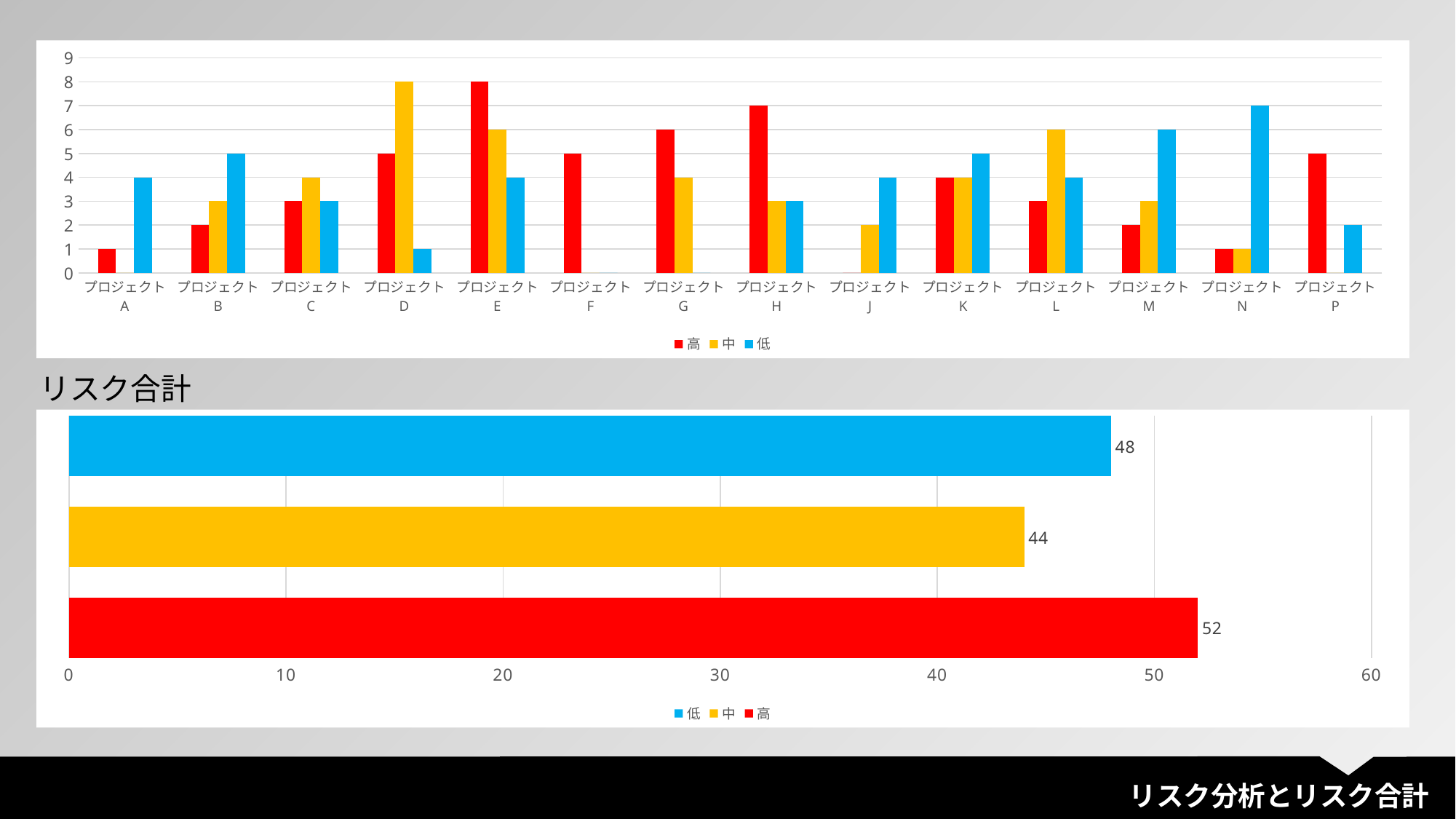
In the bottom chart titled リスク合計, how many bars are plotted? 3 In the bottom chart titled リスク合計, what is the value for 高? 52 In the bottom chart titled リスク合計, which category has the highest value? 高 What kind of chart is the bottom chart titled リスク合計? bar chart In the bottom chart titled リスク合計, what is the difference between the values for 高 and 中? 8 In the bottom chart titled リスク合計, which category has the lowest value? 中 In the bottom chart titled リスク合計, is the value for 低 greater or less than 50? less In the top chart, how many series does the legend list? 3 In the top chart, which is larger for プロジェクトD: 中 or 低? 中 In the bottom chart titled リスク合計, what is the value for 低? 48 In the top chart, what is the value of 高 for プロジェクトE? 8 In the top chart, how many project categories are shown on the x axis? 14